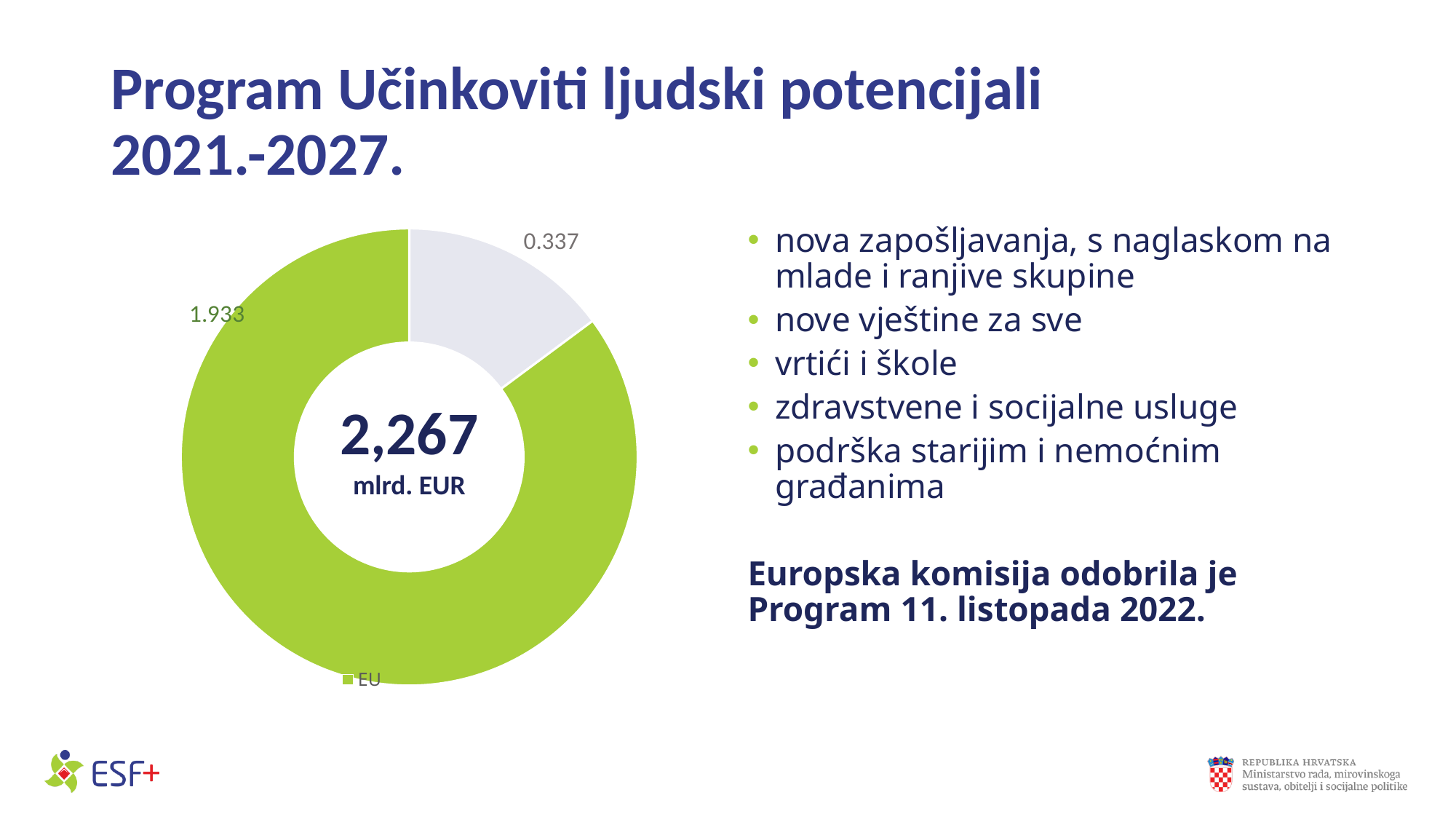
What is the legend entry shown below the doughnut chart? EU What kind of chart is shown on the slide? doughnut chart Is the EU slice larger or smaller than the grey slice? larger What value is shown for the EU slice of the doughnut chart? 1.933 Which slice of the doughnut chart is the smallest? the grey slice (0.337) Which slice of the doughnut chart is the largest? EU What value is shown on the grey slice of the doughnut chart? 0.337 What is the difference between the EU slice value and the grey slice value? 1.596 What text is shown in the centre of the doughnut chart? 2,267 mlrd. EUR How many entries does the chart legend list? 1 How many slices does the doughnut chart have? 2